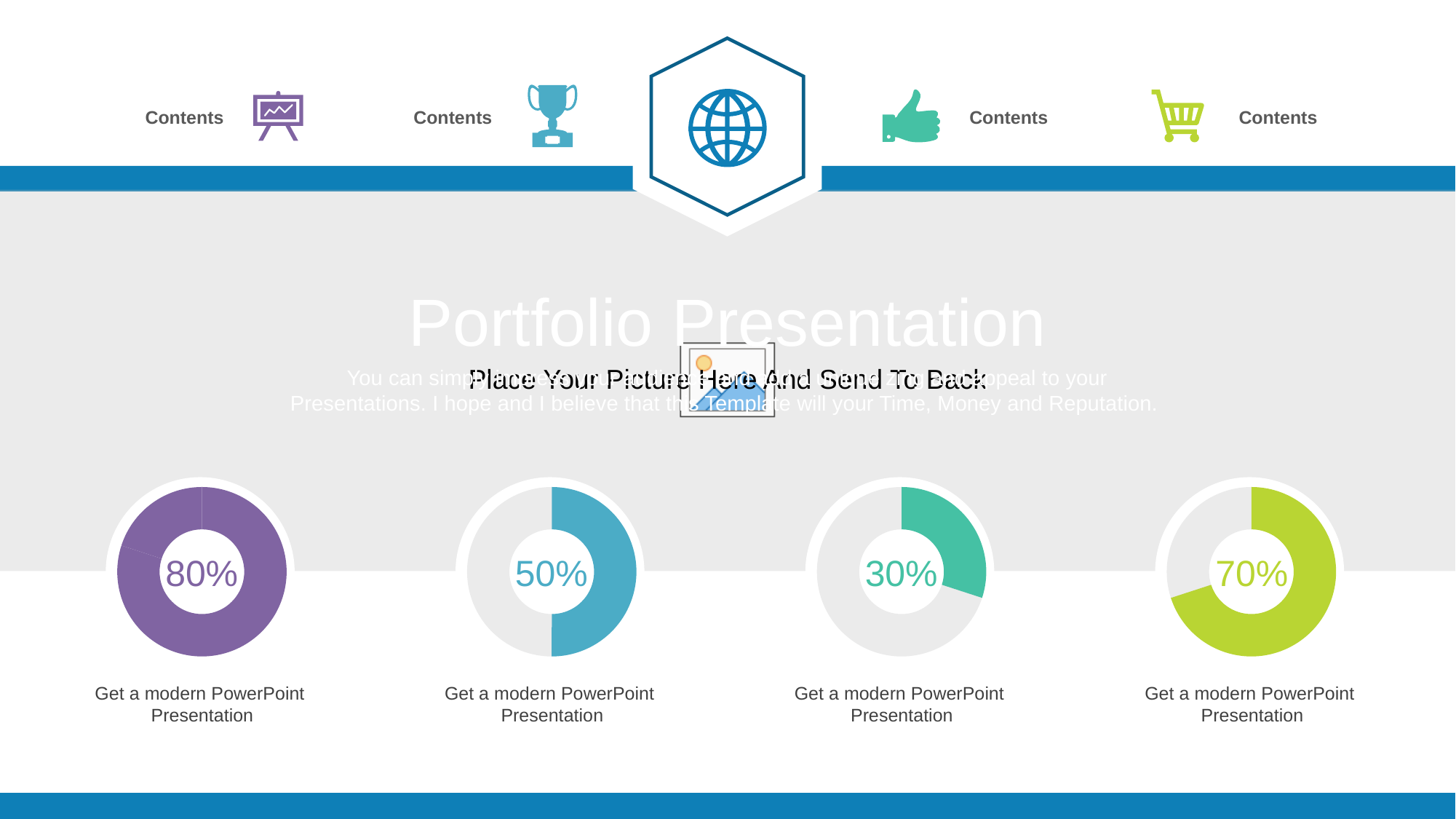
Which of the four donut charts shows the lowest percentage? The third from the left (green) chart, 30% What is the difference between the values in the rightmost donut chart and the second donut chart from the left? 20% What value is shown in the centre of the rightmost (lime green) donut chart? 70% What is the difference between the value in the leftmost donut chart and the value in the third donut chart from the left? 50% What value is shown in the centre of the leftmost (purple) donut chart? 80% Which of the four donut charts shows the highest percentage? The leftmost (purple) chart, 80% How many donut charts are shown on the slide? 4 Which is larger: the value in the second donut chart from the left or the value in the rightmost donut chart? The rightmost chart (70%) What value is shown in the centre of the third donut chart from the left (green)? 30% What kind of chart is used to display the four percentages on the slide? Donut chart What value is shown in the centre of the second donut chart from the left (blue)? 50% What colour is the filled portion of the donut chart showing 30%? Green